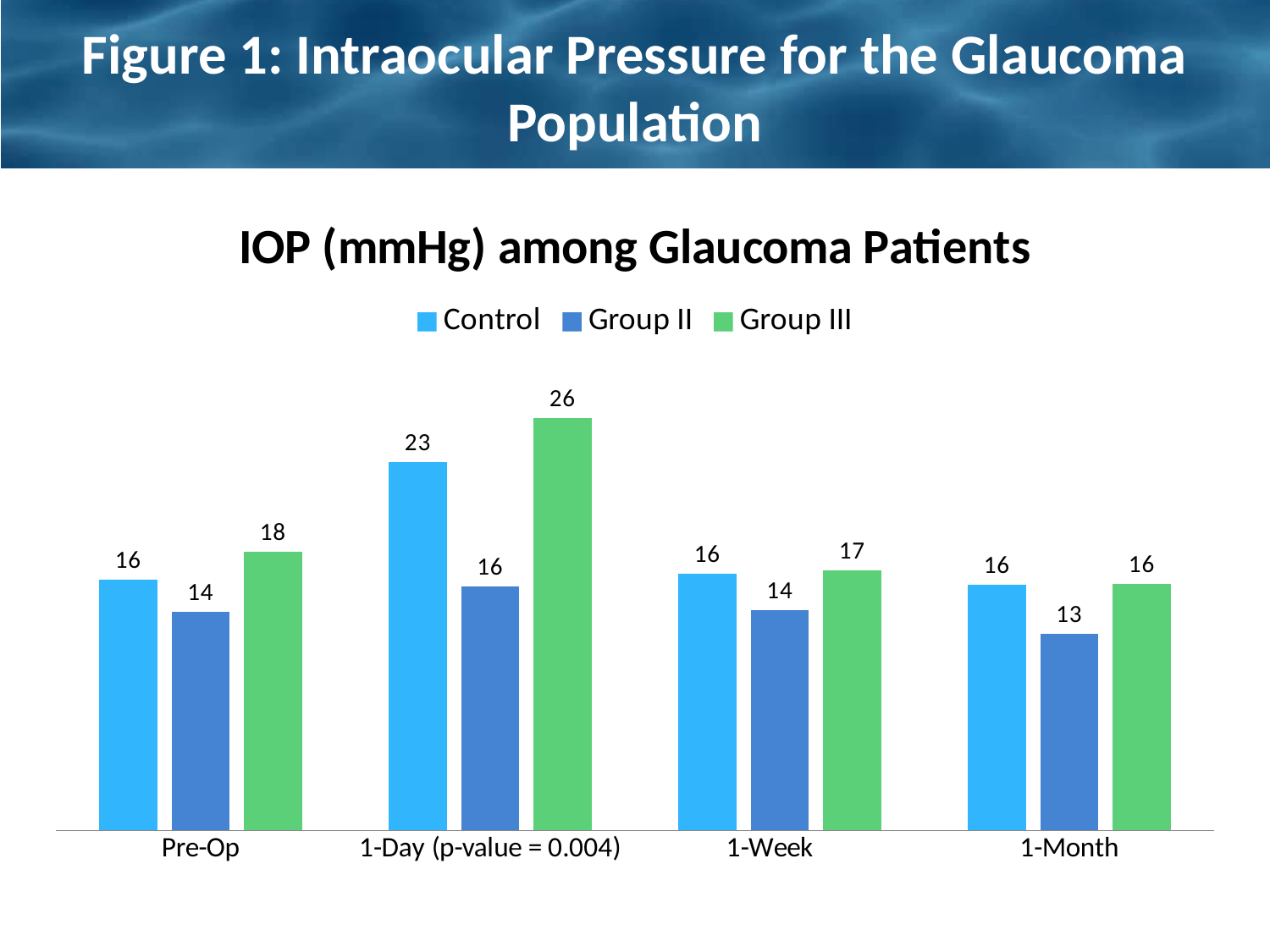
How many time-point categories are shown on the x axis? 4 At which time point does Group III have its highest IOP value? 1-Day (p-value = 0.004) What is the difference between the Group III and Control values at 1-Day (p-value = 0.004)? 3 What is the difference between the Control and Group II values at Pre-Op? 2 At which time point does Group II have its lowest IOP value? 1-Month What is the IOP value for Group II at 1-Month? 13 What is the title of the chart? IOP (mmHg) among Glaucoma Patients What kind of chart is shown on the slide? Bar chart Which is larger at 1-Week: the Control value or the Group II value? Control How many series does the legend list? 3 What is the IOP value for Control at Pre-Op? 16 What is the IOP value for Group III at 1-Day (p-value = 0.004)? 26